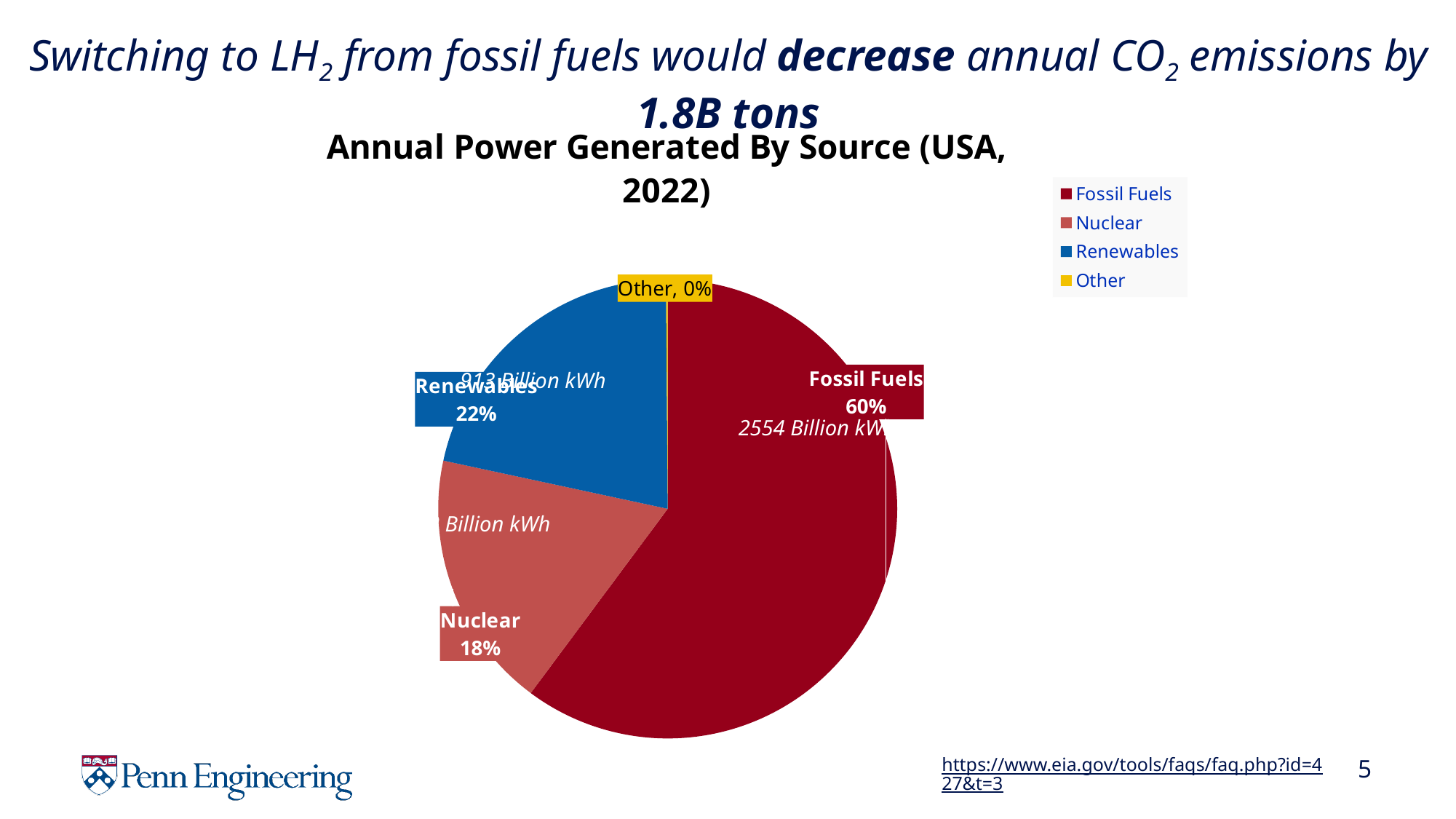
What share of the pie does Fossil Fuels represent? 60% How many categories are shown in the pie chart? 4 What share of the pie does Renewables represent? 22% Which source has the largest share of annual power generated? Fossil Fuels Which source has the smallest share of annual power generated? Other Which has a larger share, Renewables or Nuclear? Renewables What percentage is shown for the Other slice? 0% What is the title of the chart? Annual Power Generated By Source (USA, 2022) What is the difference in percentage points between the Fossil Fuels share and the Nuclear share? 42 percentage points What kind of chart is shown on the slide? Pie chart How many entries does the legend list? 4 What share of the pie does Nuclear represent? 18%